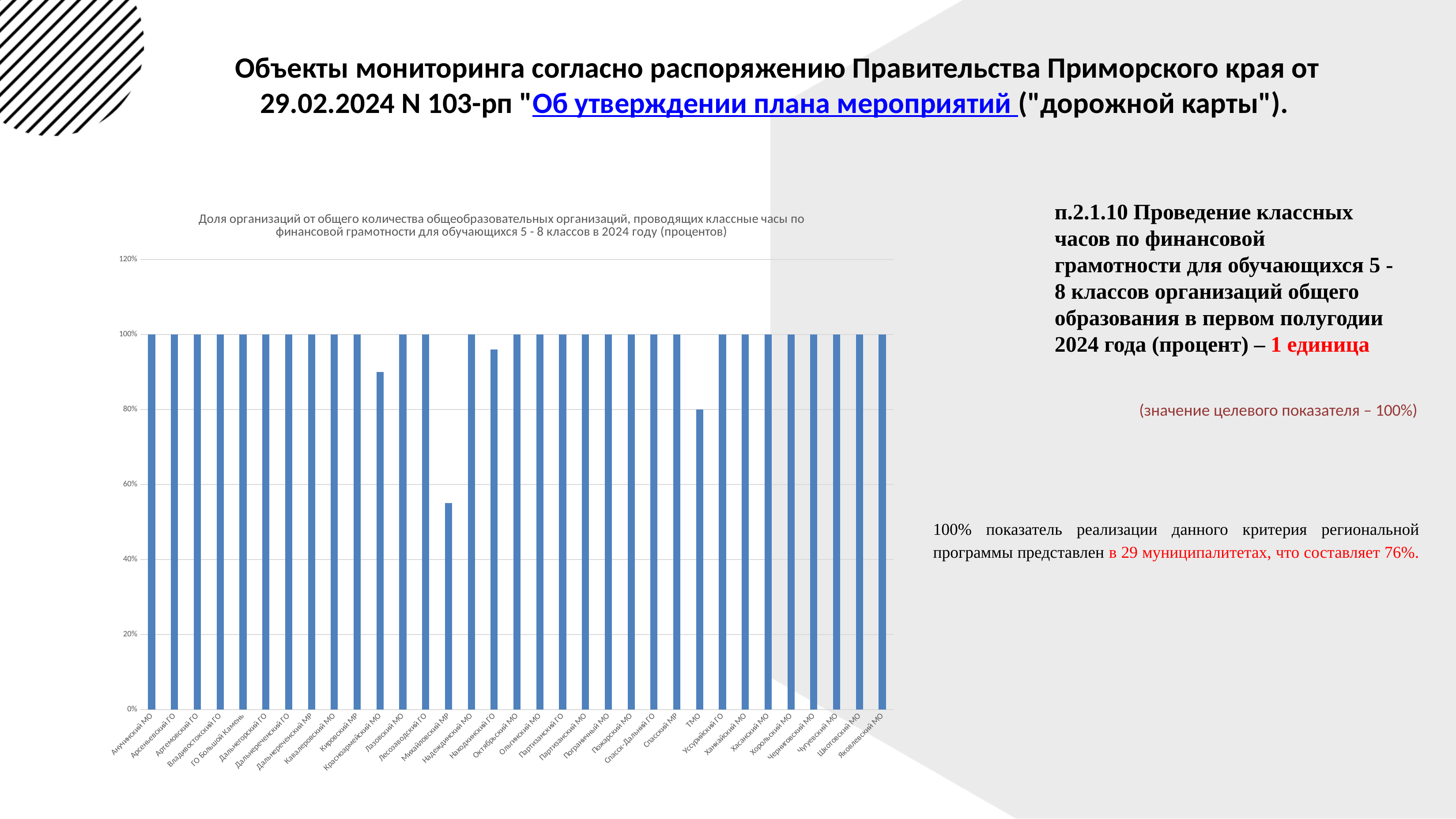
What is the value for ТМО? 80% Is the value for Красноармейский МО greater or less than 80%? greater What kind of chart is shown on the slide? Bar chart Which municipality has the lowest value in the chart? Михайловский МР Which has the larger value: Красноармейский МО or Михайловский МР? Красноармейский МО What colour are the bars in the chart? Blue What is the highest tick label shown on the chart's vertical axis? 120% What is the value for Анучинский МО? 100% How many municipalities (categories) are plotted on the x axis of the chart? 33 Which has the larger value: ТМО or Находкинский ГО? Находкинский ГО Is the value for Михайловский МР greater or less than 60%? less What is the value for Яковлевский МО? 100%